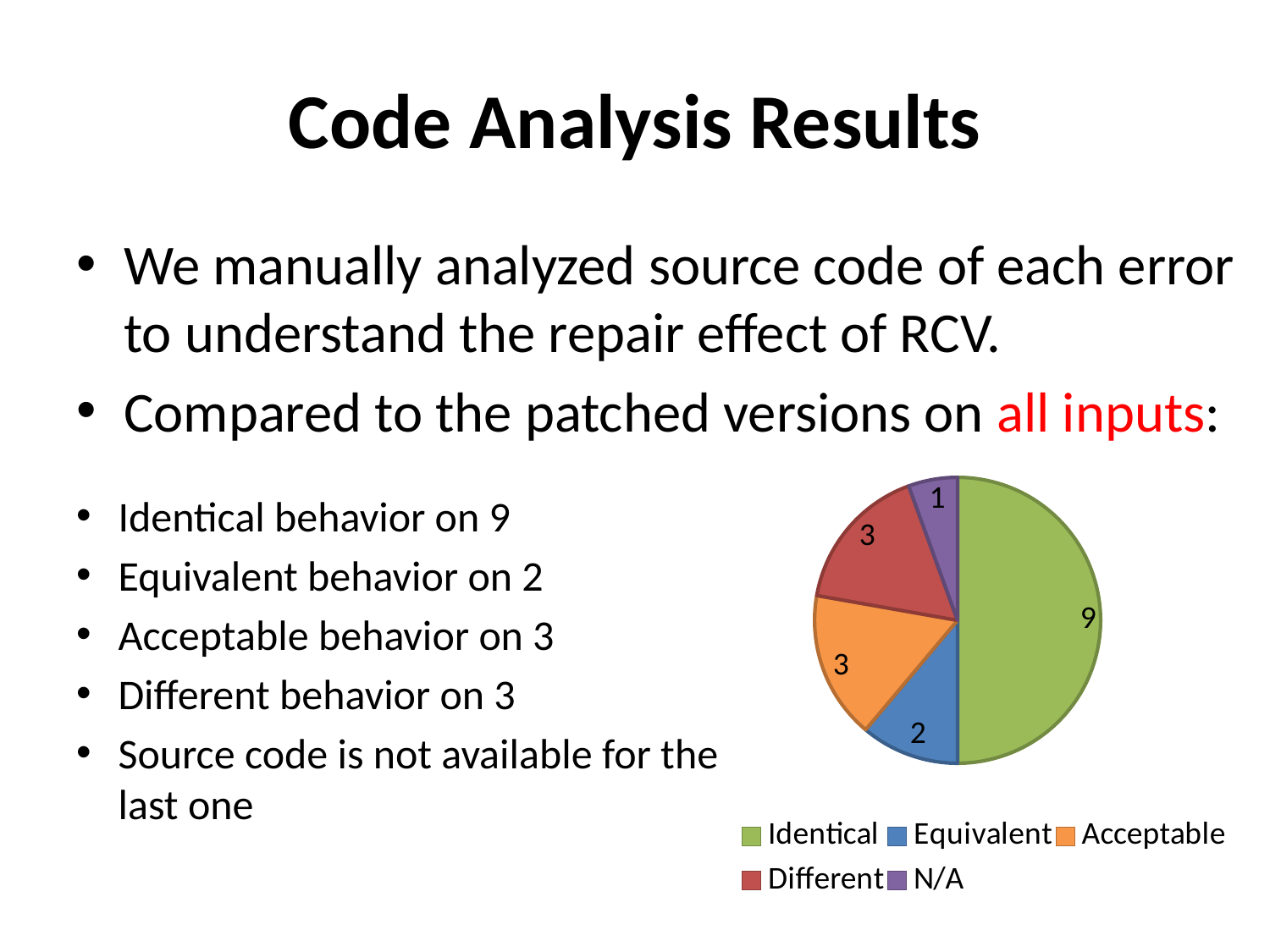
What share of the pie does the Identical slice represent? 50% What is the value of the Acceptable slice in the pie chart? 3 Which category has the largest slice in the pie chart? Identical How many entries does the pie chart's legend list? 5 What is the difference between the Identical and Equivalent values in the pie chart? 7 What is the value of the Identical slice in the pie chart? 9 Which category has the smallest slice in the pie chart? N/A What kind of chart is shown on the slide? pie chart What is the value of the Equivalent slice in the pie chart? 2 What is the value of the N/A slice in the pie chart? 1 How many slices does the pie chart have? 5 Which is larger in the pie chart, the Different slice or the N/A slice? Different